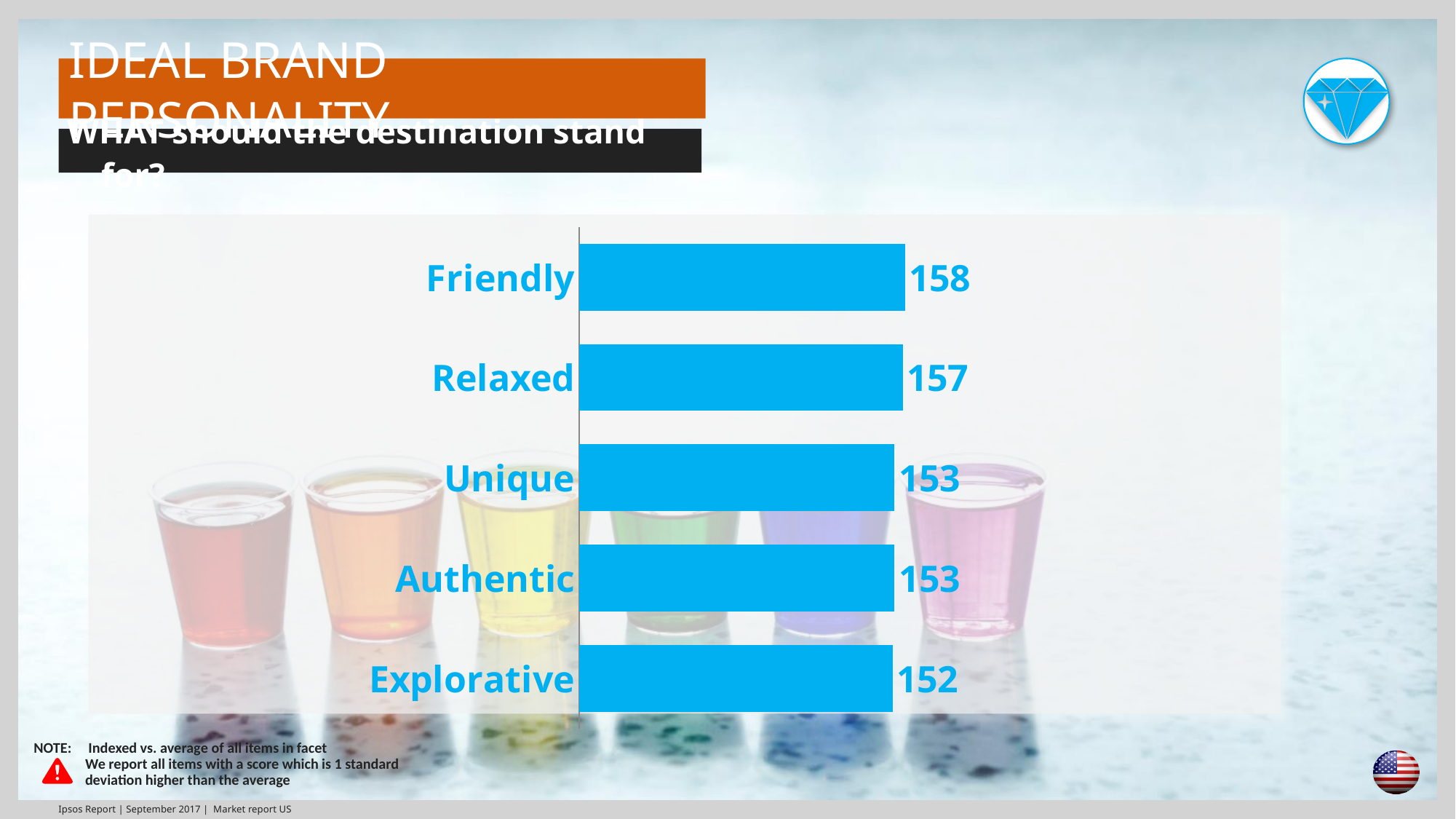
Which category has the lowest value? Explorative How many categories are shown in the chart? 5 Which has a larger value, Relaxed or Authentic? Relaxed What is the value for Unique? 153 What is the value for Friendly? 158 What is the value for Relaxed? 157 Which two categories share the same value of 153? Unique and Authentic Which category has the highest value? Friendly What kind of chart is shown on the slide? Bar chart What is the difference between the values for Relaxed and Unique? 4 What is the difference between the values for Friendly and Explorative? 6 What is the value for Explorative? 152